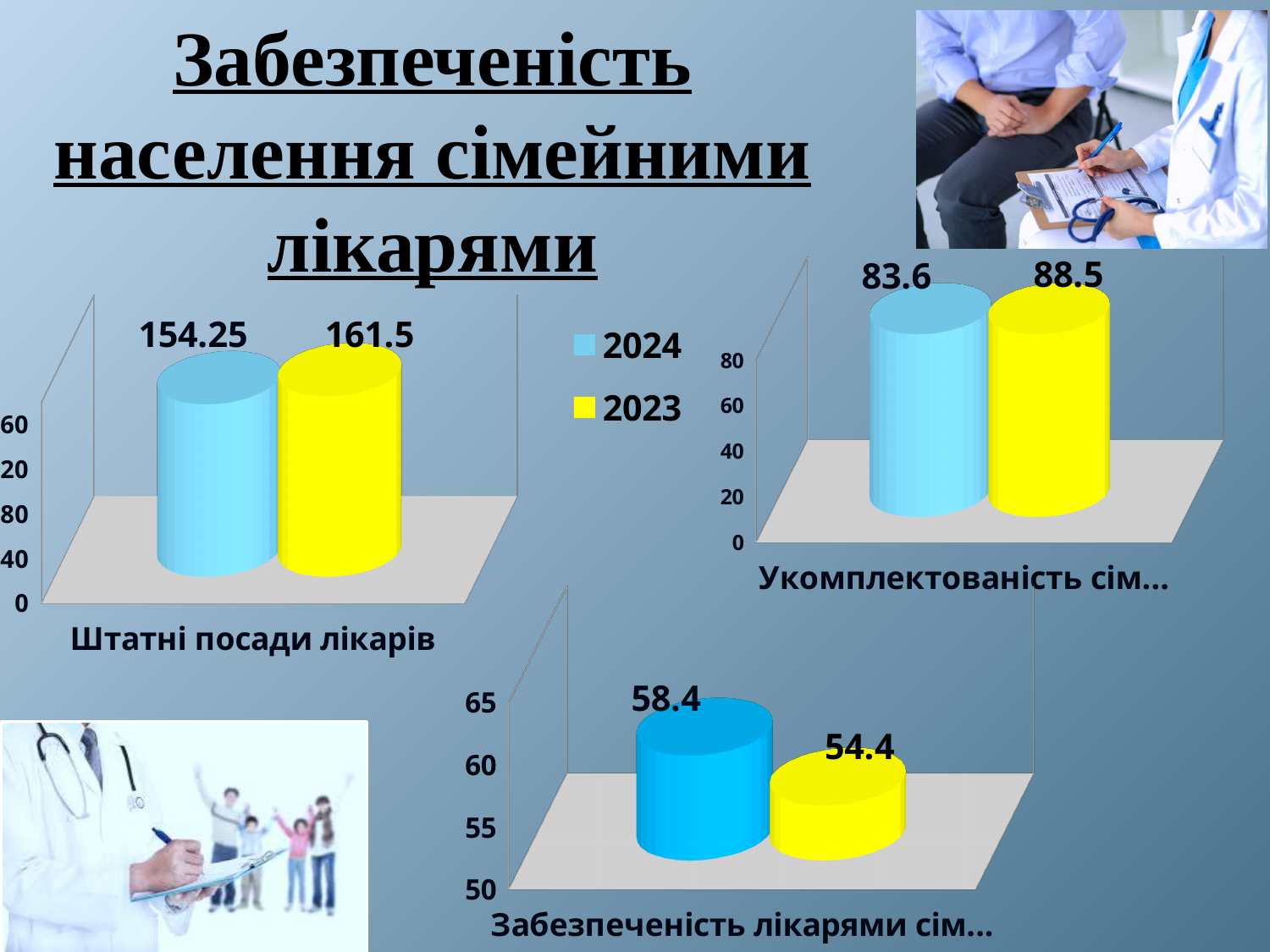
In the chart titled "Укомплектованість сім..." (top right), which year has the higher value? 2023 What type of chart is the chart titled "Штатні посади лікарів"? Bar chart In the chart titled "Забезпеченість лікарями сім..." (bottom), what is the value for the blue bar (2024)? 58.4 In the chart titled "Укомплектованість сім..." (top right), what is the difference between the 2023 and 2024 values? 4.9 In the chart titled "Штатні посади лікарів", what is the value for 2023? 161.5 In the chart titled "Забезпеченість лікарями сім..." (bottom), which year has the higher value? 2024 In the chart titled "Укомплектованість сім..." (top right), what is the value for 2024? 83.6 In the chart titled "Штатні посади лікарів", what is the difference between the 2023 and 2024 values? 7.25 How many series does the legend on the slide list? 2 In the chart titled "Штатні посади лікарів", what is the value for 2024? 154.25 In the chart titled "Забезпеченість лікарями сім..." (bottom), what is the value for the yellow bar (2023)? 54.4 In the chart titled "Укомплектованість сім..." (top right), what is the value for 2023? 88.5